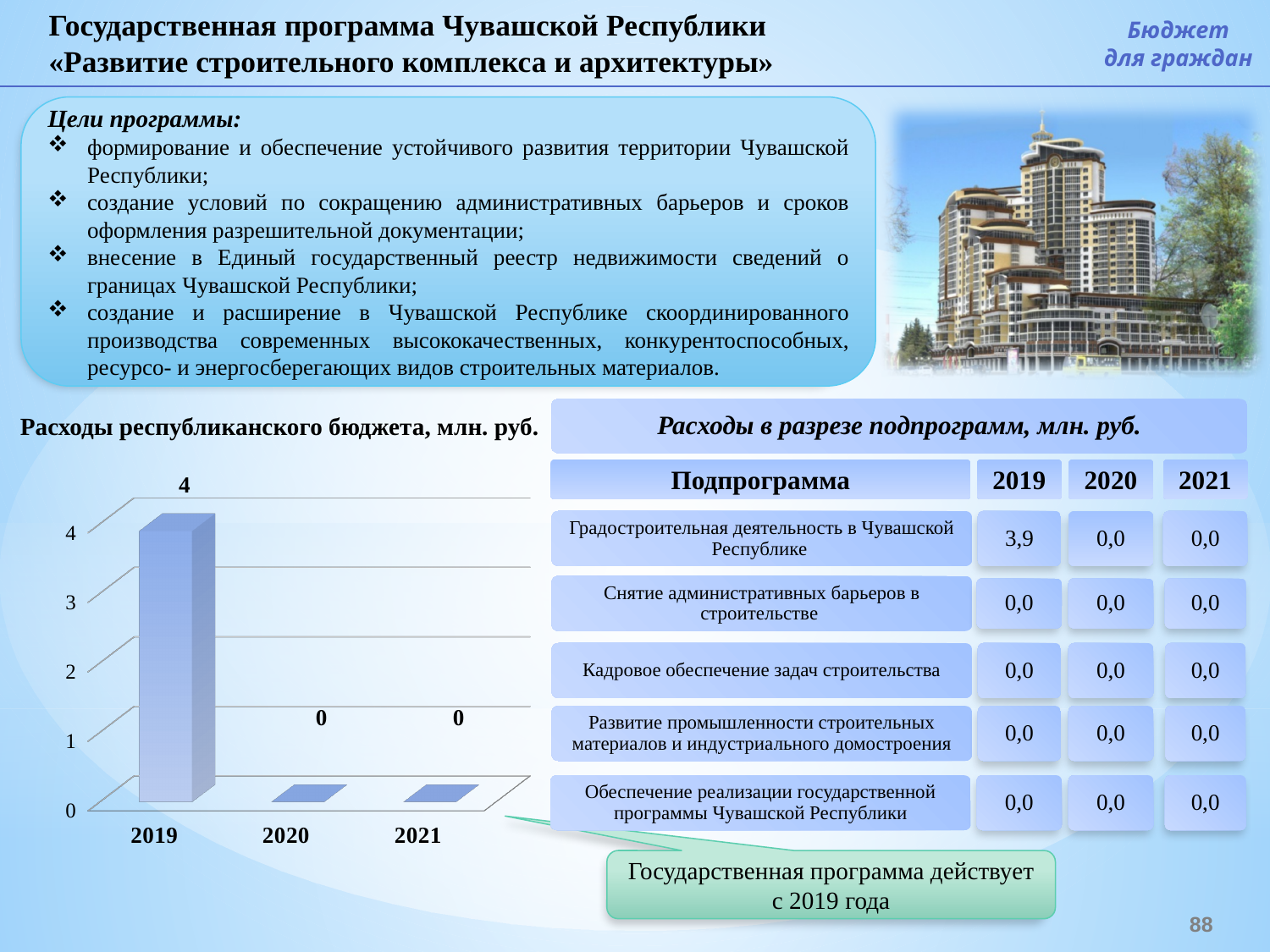
Is the value for 2019 in the chart 'Расходы республиканского бюджета, млн. руб.' greater or less than 3? greater Do the values in the chart 'Расходы республиканского бюджета, млн. руб.' rise or fall from 2019 to 2020? fall Which year has the highest value in the chart 'Расходы республиканского бюджета, млн. руб.'? 2019 What is the value for 2021 in the chart 'Расходы республиканского бюджета, млн. руб.'? 0 What is the highest tick value shown on the vertical axis of the chart 'Расходы республиканского бюджета, млн. руб.'? 4 What is the difference between the values for 2019 and 2020 in the chart 'Расходы республиканского бюджета, млн. руб.'? 4 How many years are shown on the x axis of the chart 'Расходы республиканского бюджета, млн. руб.'? 3 What kind of chart is 'Расходы республиканского бюджета, млн. руб.'? bar chart Which is larger in the chart 'Расходы республиканского бюджета, млн. руб.': the value for 2019 or the value for 2021? 2019 What is the title of the bar chart on the slide? Расходы республиканского бюджета, млн. руб. What is the value for 2019 in the chart 'Расходы республиканского бюджета, млн. руб.'? 4 What is the value for 2020 in the chart 'Расходы республиканского бюджета, млн. руб.'? 0